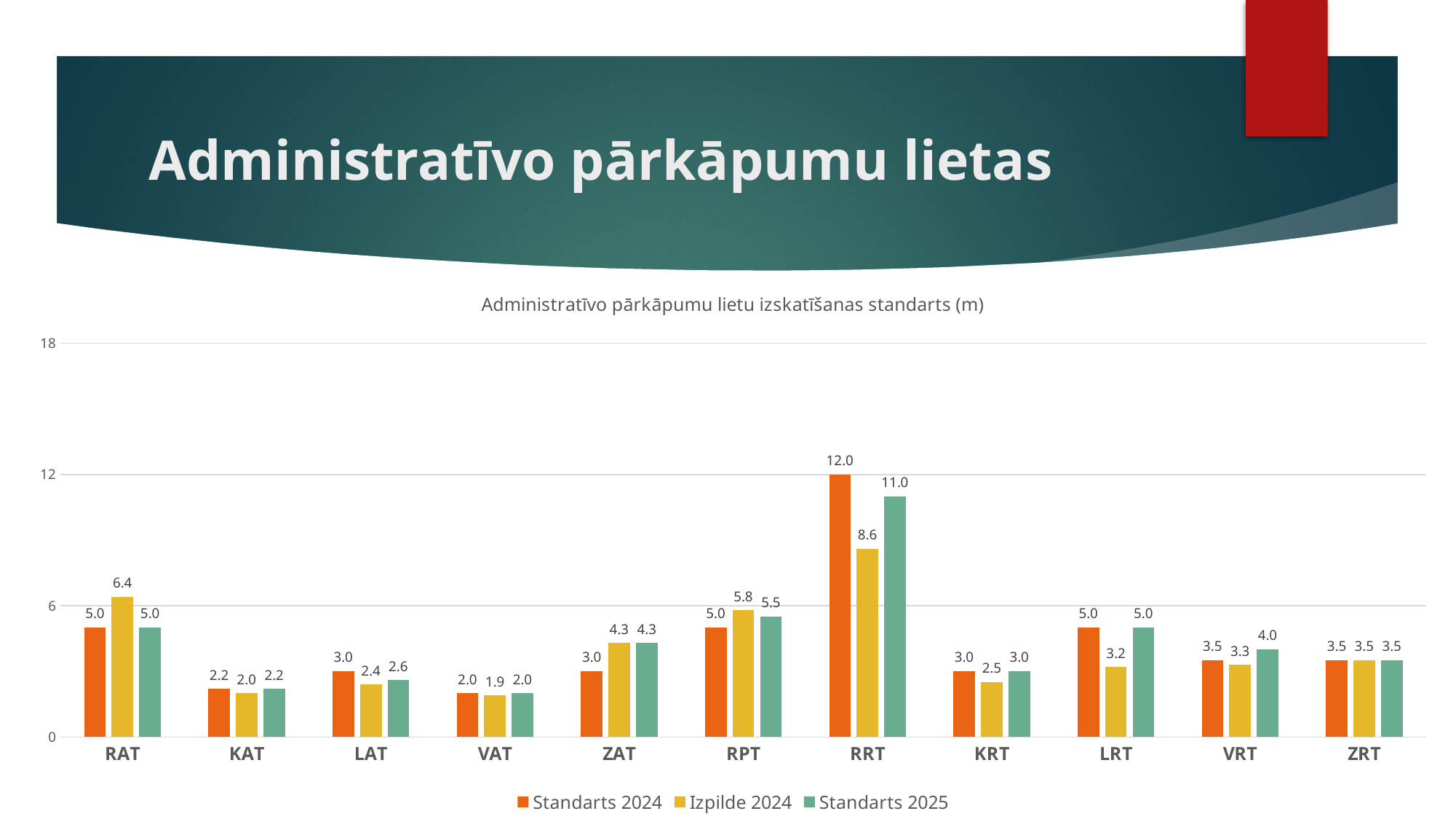
Which category has the lowest Izpilde 2024 value? VAT What is the Izpilde 2024 value for RRT? 8.6 How many series does the legend list? 3 Which category has the highest Standarts 2024 value? RRT Is the Standarts 2025 value for RRT greater or less than 6? greater What is the difference between the Izpilde 2024 and Standarts 2024 values for RAT? 1.4 What is the Standarts 2025 value for VRT? 4.0 What is the Standarts 2024 value for LAT? 3.0 Which is larger for LRT: the Standarts 2024 value or the Izpilde 2024 value? Standarts 2024 What is the difference between the Standarts 2024 and Izpilde 2024 values for RRT? 3.4 How many categories are shown on the x axis? 11 What kind of chart is shown on the slide? Bar chart